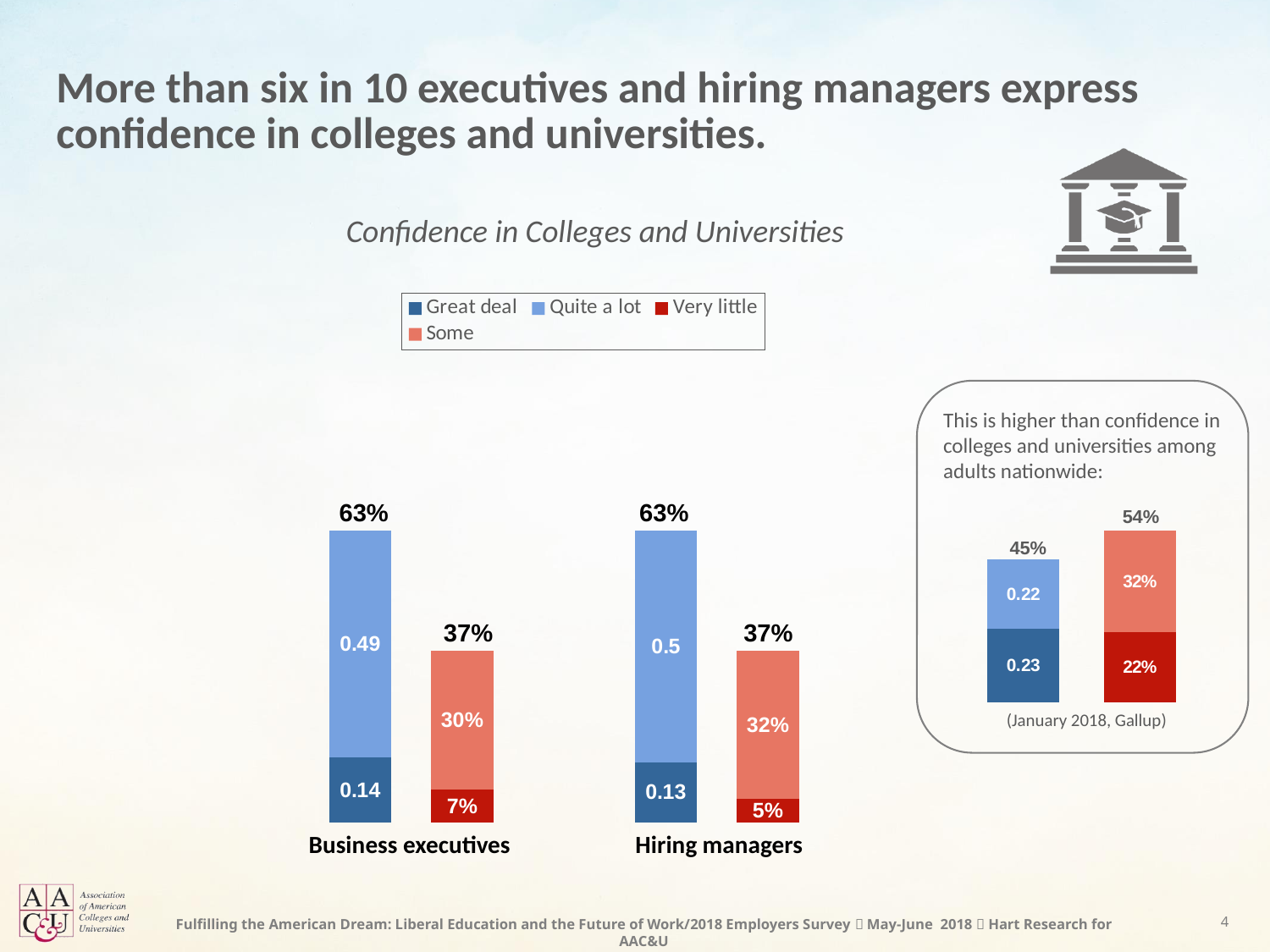
In the 'Confidence in Colleges and Universities' chart, what is the 'Great deal' value for Business executives? 0.14 In the small chart in the callout box on the right (adults nationwide), what is the total shown above the red stacked bar? 54% In the 'Confidence in Colleges and Universities' chart, what is the difference between the 'Some' values for Hiring managers and Business executives? 2% In the 'Confidence in Colleges and Universities' chart, what is the total shown above the red stacked bar for Hiring managers? 37% In the 'Confidence in Colleges and Universities' chart, what is the 'Very little' value for Hiring managers? 5% In the 'Confidence in Colleges and Universities' chart, what is the 'Quite a lot' value for Hiring managers? 0.5 In the 'Confidence in Colleges and Universities' chart, which is larger: the 'Very little' value for Business executives or for Hiring managers? Business executives In the 'Confidence in Colleges and Universities' chart, what is the total shown above the blue stacked bar for Business executives? 63% What kind of chart is the 'Confidence in Colleges and Universities' chart? Stacked bar chart In the small chart in the callout box on the right (adults nationwide), what is the 'Great deal' value? 0.23 In the 'Confidence in Colleges and Universities' chart, what is the 'Some' value for Business executives? 30% In the 'Confidence in Colleges and Universities' chart, how many series does the legend list? 4